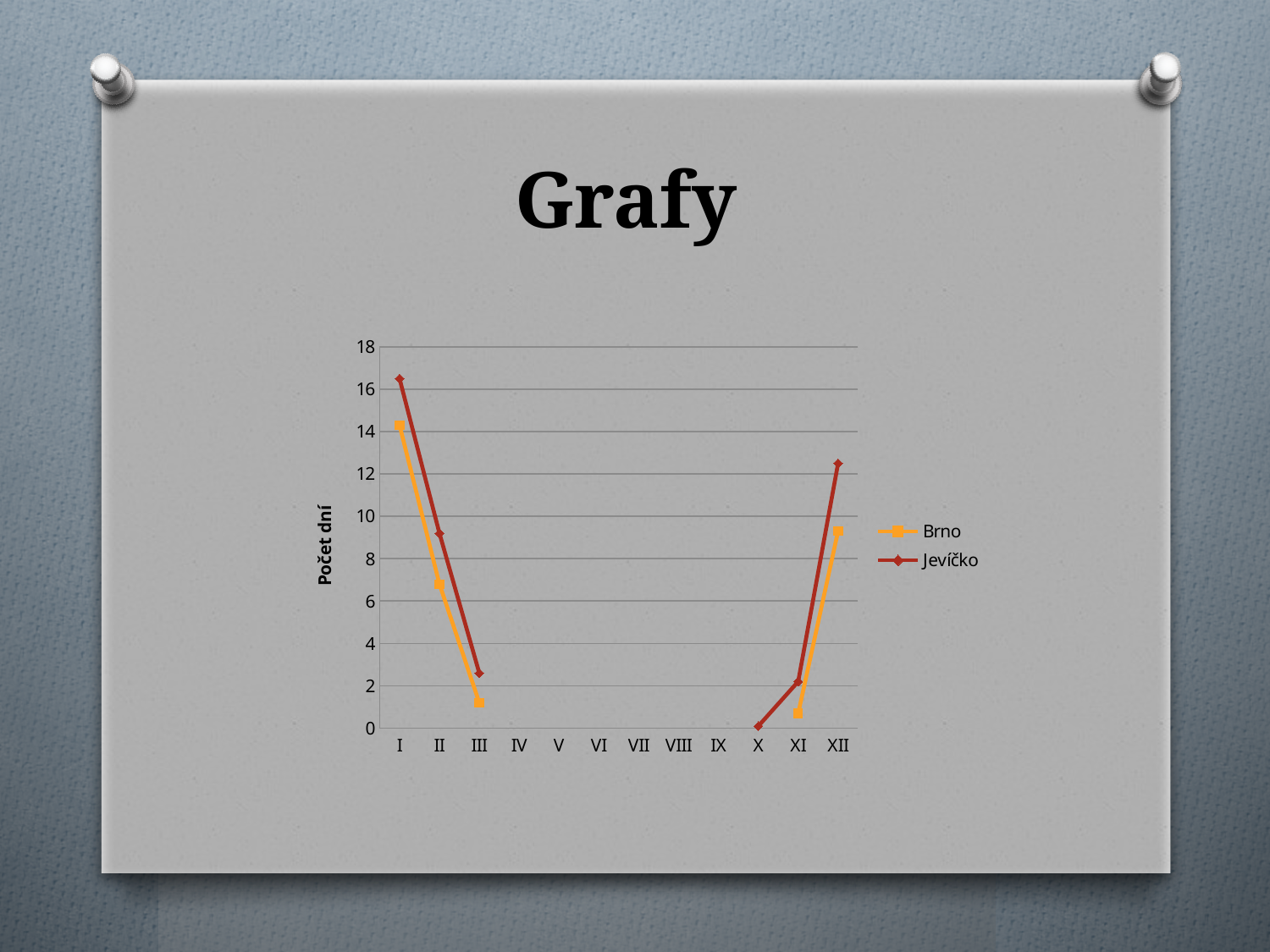
How many series does the legend list? 2 What is the title of the vertical axis? Počet dní Is the value for Jevíčko at I greater or less than 16? greater Which series is drawn in red? Jevíčko At which category does the Jevíčko series reach its highest value? I Which series has the higher value at II, Brno or Jevíčko? Jevíčko Is the value for Brno at III greater or less than 2? less Do the values for Jevíčko rise or fall from I to III? fall How many categories are shown on the x axis? 12 Is the value for Jevíčko at XII greater or less than 12? greater What kind of chart is shown on the slide? line chart